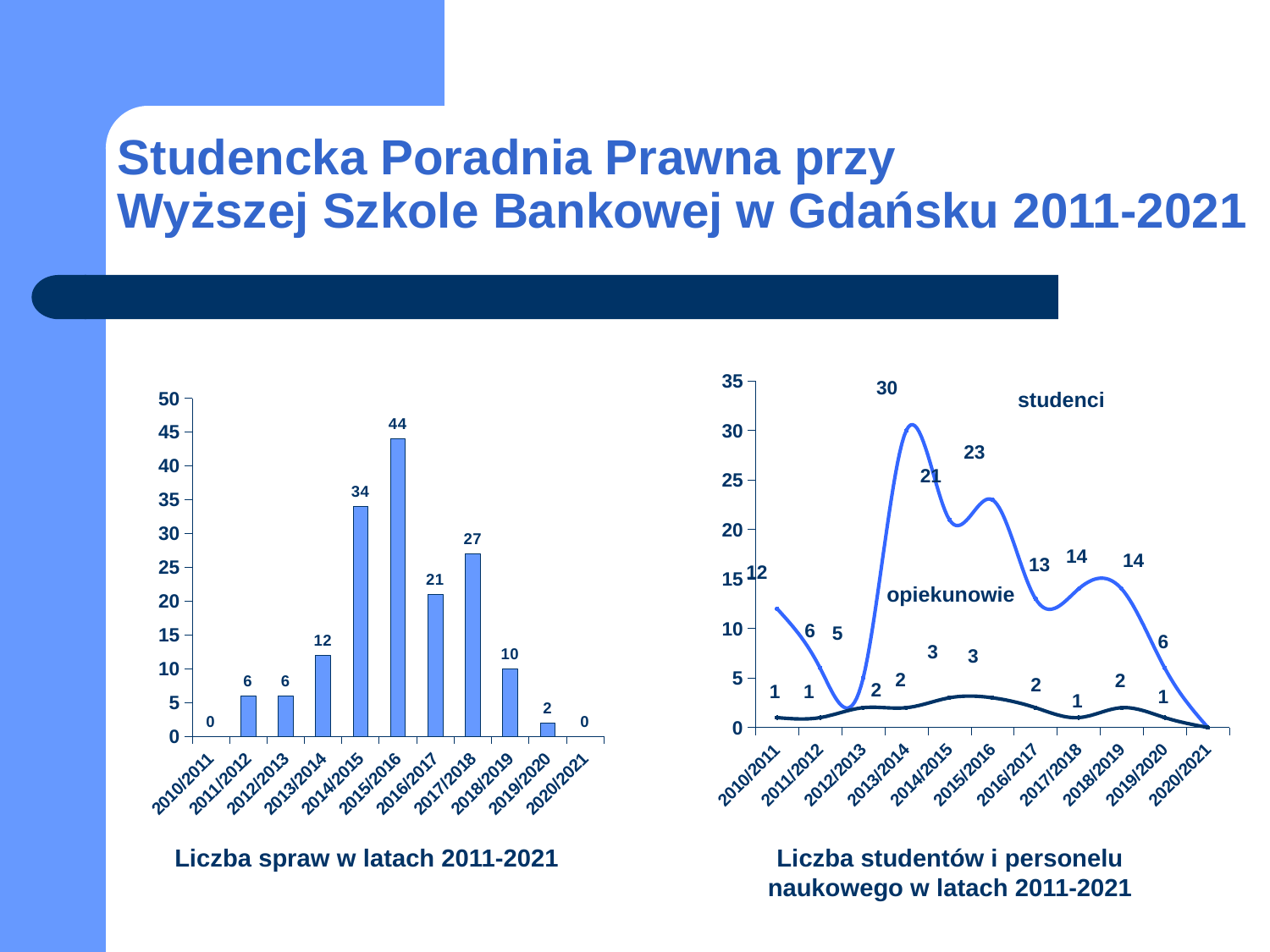
In the chart 'Liczba studentów i personelu naukowego w latach 2011-2021', what is the value for studenci in 2013/2014? 30 In the chart 'Liczba spraw w latach 2011-2021', what is the value for 2017/2018? 27 What kind of chart is 'Liczba spraw w latach 2011-2021'? bar chart In the chart 'Liczba spraw w latach 2011-2021', what is the difference between the values for 2015/2016 and 2014/2015? 10 What kind of chart is 'Liczba studentów i personelu naukowego w latach 2011-2021'? line chart In the chart 'Liczba studentów i personelu naukowego w latach 2011-2021', in which year does the studenci series reach its highest value? 2013/2014 How many year categories are shown on the x axis of the chart 'Liczba spraw w latach 2011-2021'? 11 In the chart 'Liczba spraw w latach 2011-2021', what is the value for 2015/2016? 44 In the chart 'Liczba spraw w latach 2011-2021', which year has the highest value? 2015/2016 In the chart 'Liczba studentów i personelu naukowego w latach 2011-2021', what is the value for opiekunowie in 2015/2016? 3 How many series are plotted in the chart 'Liczba studentów i personelu naukowego w latach 2011-2021'? 2 In the chart 'Liczba spraw w latach 2011-2021', which is larger, the value for 2016/2017 or the value for 2018/2019? 2016/2017